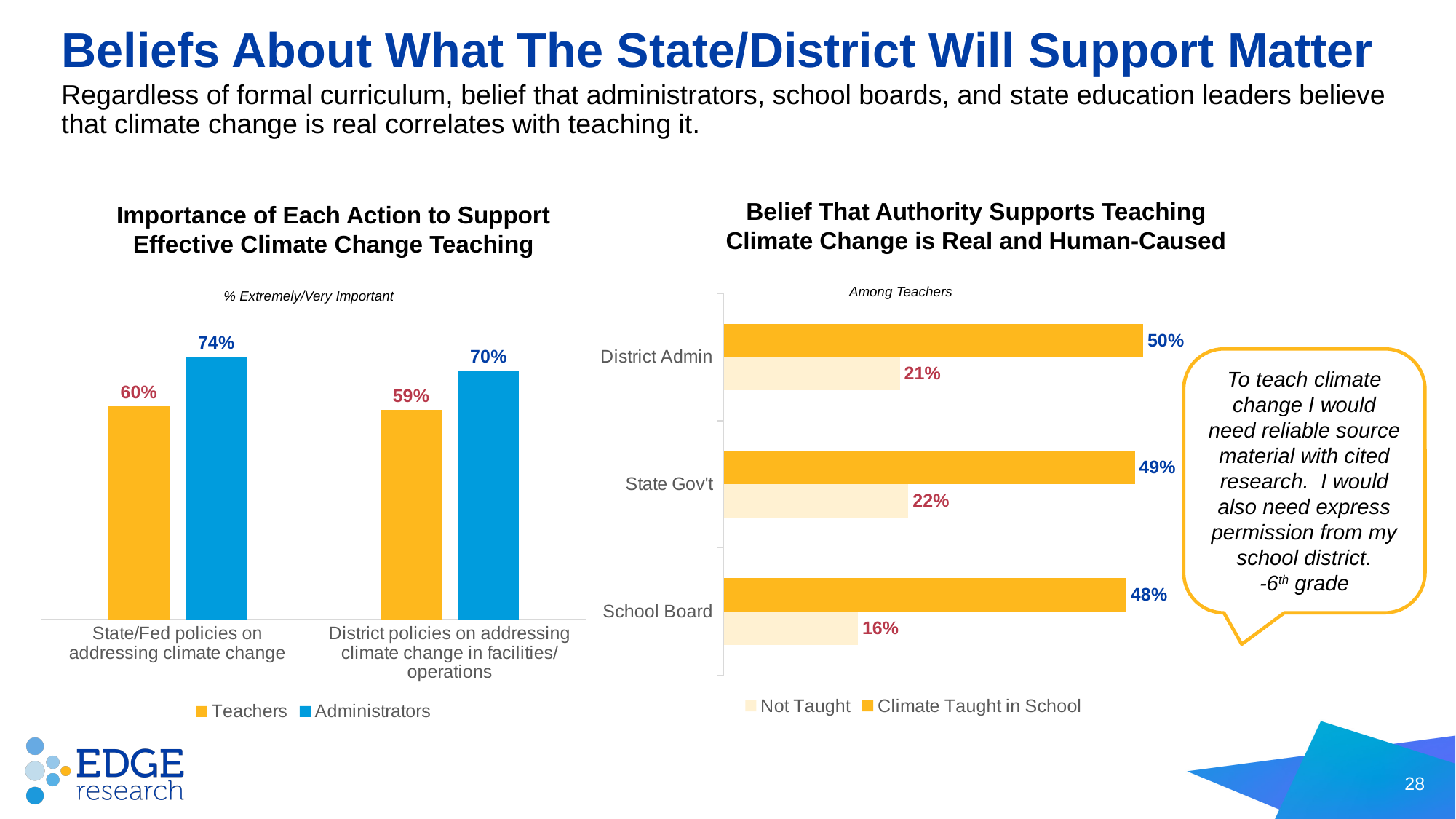
How many categories are shown in the 'Belief That Authority Supports Teaching Climate Change is Real and Human-Caused' chart? 3 In the 'Belief That Authority Supports Teaching Climate Change is Real and Human-Caused' chart, which colour represents 'Climate Taught in School'? Orange In the 'Importance of Each Action to Support Effective Climate Change Teaching' chart, what is the value for Teachers on 'District policies on addressing climate change in facilities/operations'? 59% In the 'Importance of Each Action to Support Effective Climate Change Teaching' chart, which series has the higher value for 'District policies on addressing climate change in facilities/operations'? Administrators In the 'Importance of Each Action to Support Effective Climate Change Teaching' chart, what is the value for Administrators on 'State/Fed policies on addressing climate change'? 74% How many series does the legend list in the 'Importance of Each Action to Support Effective Climate Change Teaching' chart? 2 In the 'Belief That Authority Supports Teaching Climate Change is Real and Human-Caused' chart, which category has the lowest 'Not Taught' value? School Board In the 'Belief That Authority Supports Teaching Climate Change is Real and Human-Caused' chart, what is the difference between 'Climate Taught in School' and 'Not Taught' for State Gov't? 27 percentage points In the 'Belief That Authority Supports Teaching Climate Change is Real and Human-Caused' chart, what is the 'Not Taught' value for School Board? 16% In the 'Importance of Each Action to Support Effective Climate Change Teaching' chart, what is the difference between Administrators and Teachers for 'State/Fed policies on addressing climate change'? 14 percentage points In the 'Belief That Authority Supports Teaching Climate Change is Real and Human-Caused' chart, what is the 'Climate Taught in School' value for District Admin? 50% What kind of chart is the 'Belief That Authority Supports Teaching Climate Change is Real and Human-Caused' chart? Bar chart